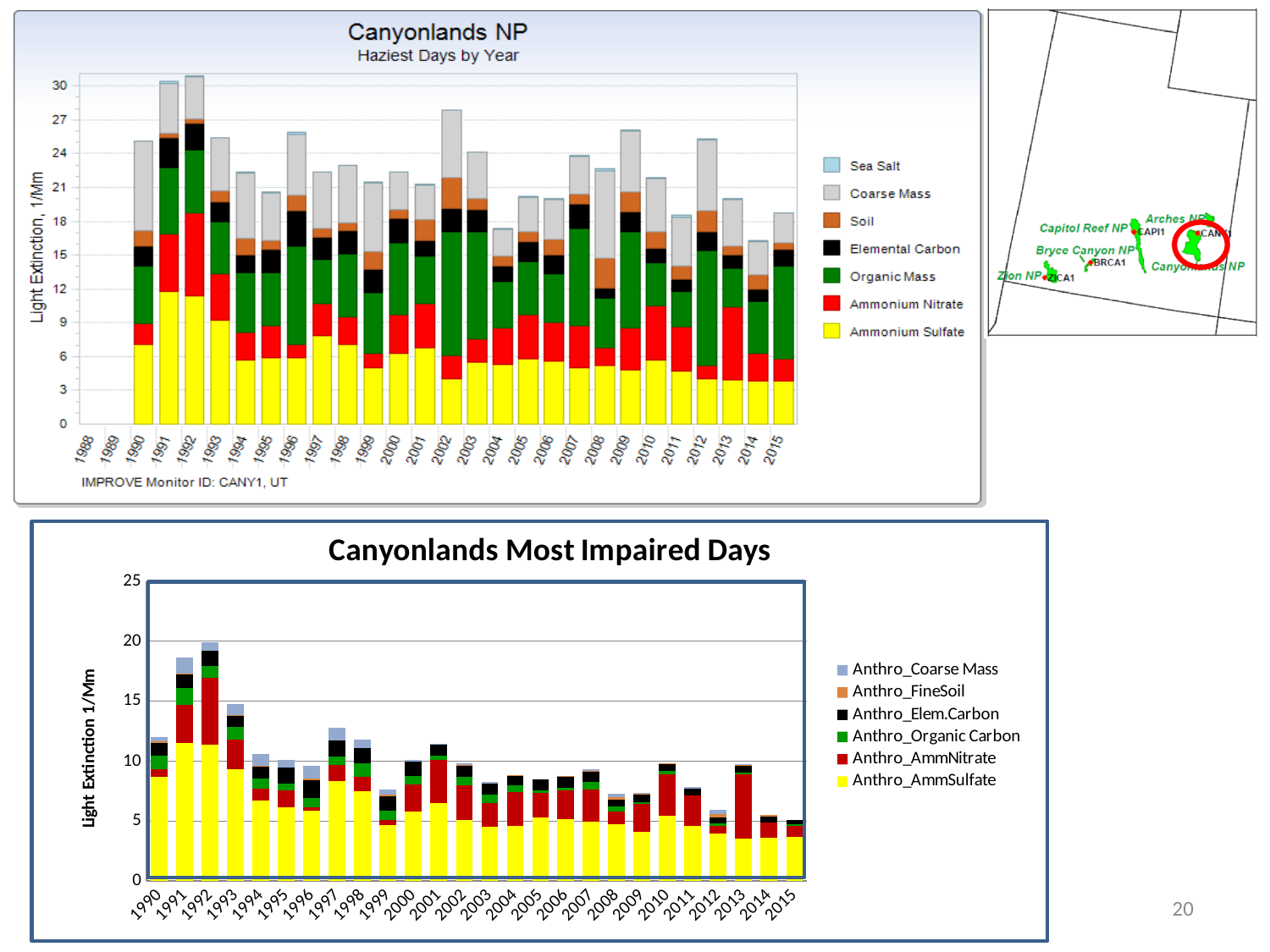
What kind of chart is the 'Canyonlands Most Impaired Days' chart? stacked bar chart In the 'Canyonlands Most Impaired Days' chart, is the total for 2015 greater or less than 10? less In the 'Canyonlands NP Haziest Days by Year' chart, which year has the tallest stacked bar? 1992 In the 'Canyonlands Most Impaired Days' chart, how many years have bars plotted? 26 In the 'Canyonlands Most Impaired Days' chart, which year has the tallest stacked bar? 1992 How many series does the legend of the 'Canyonlands NP Haziest Days by Year' chart list? 7 In the 'Canyonlands Most Impaired Days' chart, which year has the larger total, 2010 or 2012? 2010 What IMPROVE Monitor ID is shown under the 'Canyonlands NP Haziest Days by Year' chart? CANY1, UT How many series does the legend of the 'Canyonlands Most Impaired Days' chart list? 6 In the 'Canyonlands Most Impaired Days' chart, do the totals generally rise or fall from 1990 to 2015? fall In the 'Canyonlands NP Haziest Days by Year' chart, is the total for 2014 greater or less than 18? less In the 'Canyonlands Most Impaired Days' chart, is the total for 1992 greater or less than 15? greater